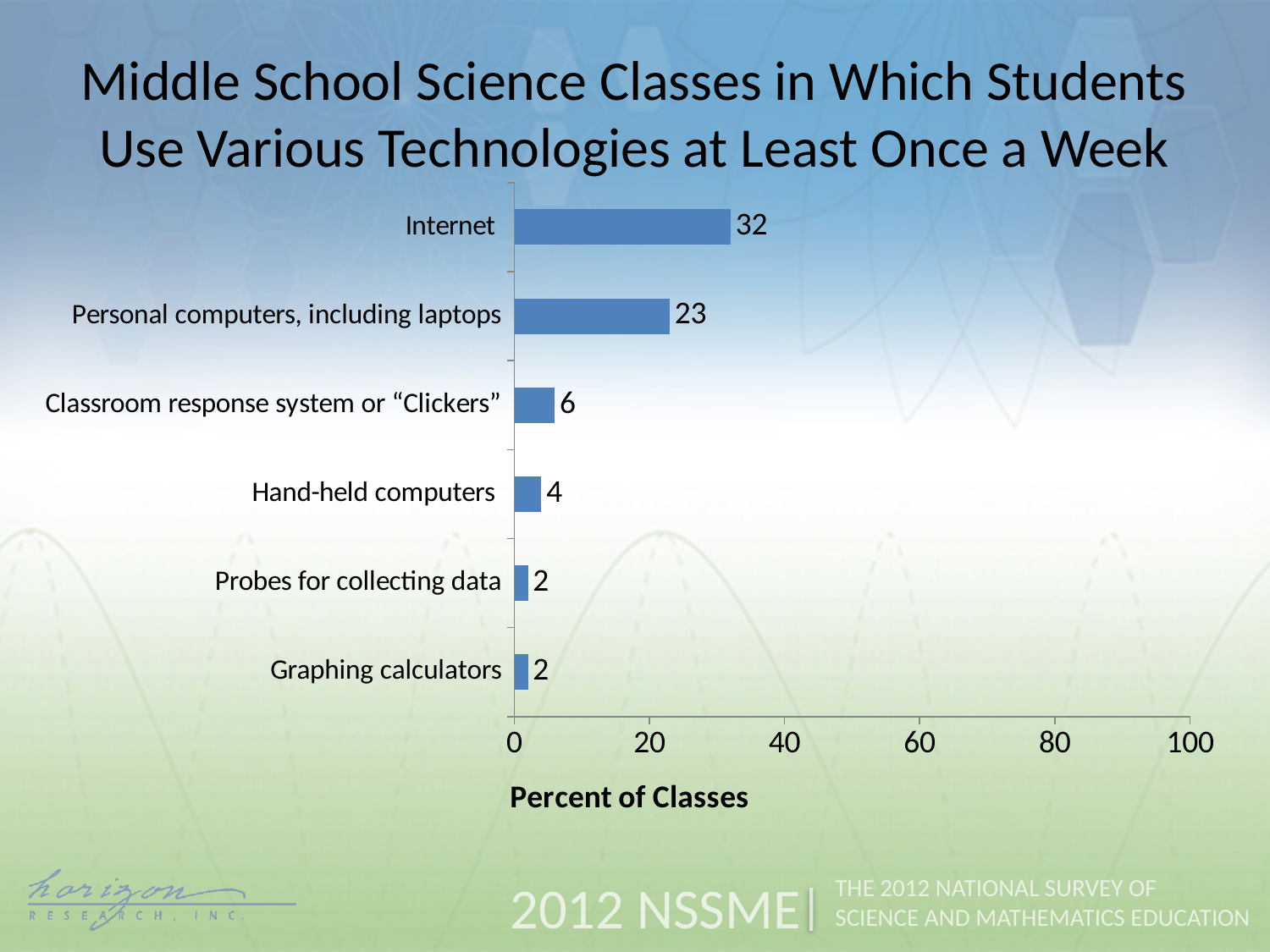
Which is larger, the value for Hand-held computers or the value for Probes for collecting data? Hand-held computers What is the label of the horizontal axis? Percent of Classes What is the difference between the values for Internet and Personal computers, including laptops? 9 What is the value for Classroom response system or "Clickers"? 6 What kind of chart is shown on the slide? bar chart Which technology has the highest percent of classes? Internet What is the value for Hand-held computers? 4 Is the value for Internet greater or less than 40? less What percent of classes use the Internet at least once a week? 32 What is the value for Personal computers, including laptops? 23 How many technology categories are shown in the chart? 6 What is the difference between the values for Classroom response system or "Clickers" and Graphing calculators? 4